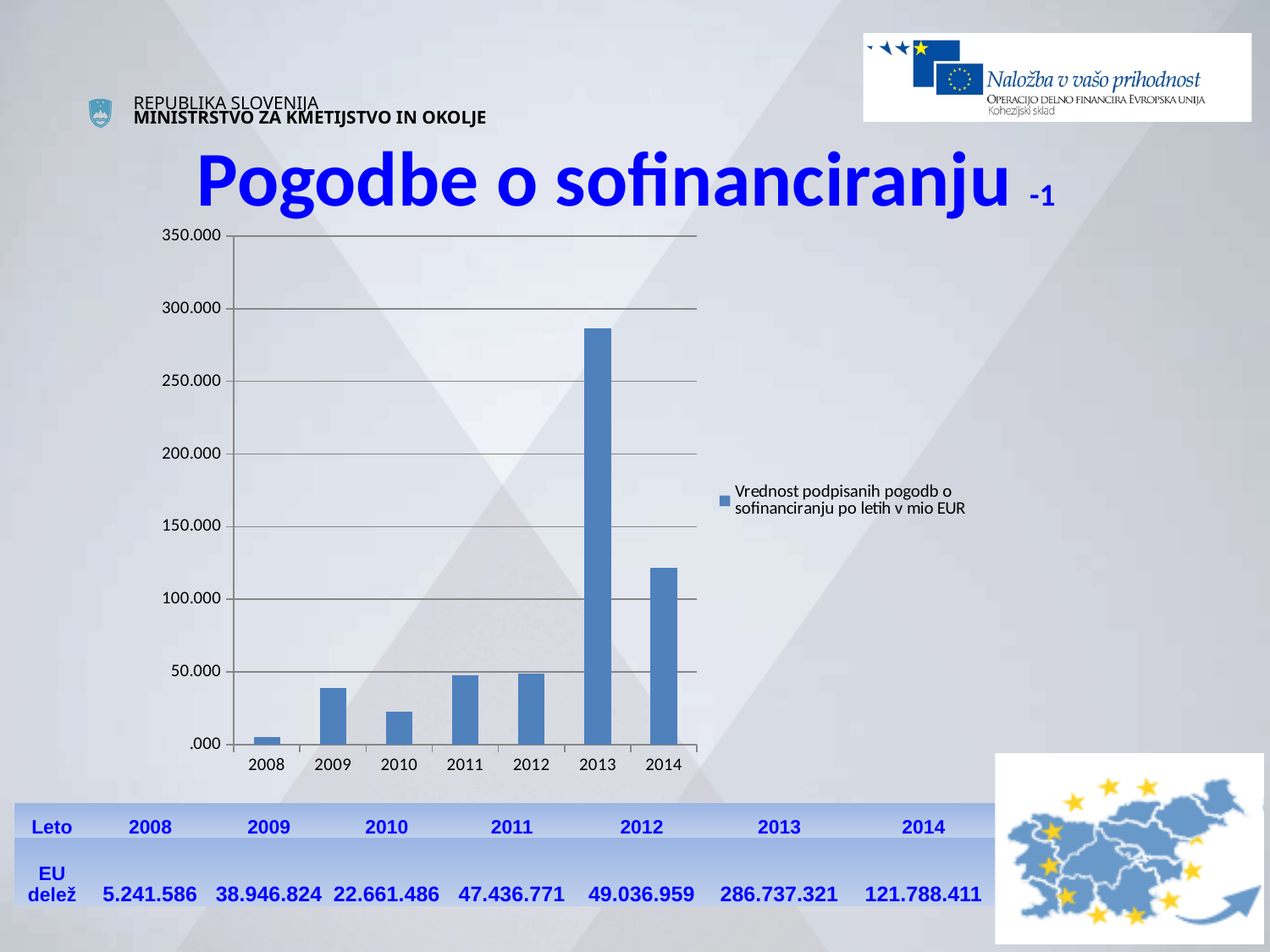
Which year has the larger bar, 2009 or 2010? 2009 Does the value rise or fall from 2013 to 2014? fall According to the table below the chart, what is the EU delež for 2013? 286.737.321 How many years are shown on the x axis of the chart? 7 Is the value for 2010 greater or less than 50.000? less Which year has the lowest bar in the chart? 2008 Is the value for 2014 greater or less than 100.000? greater What kind of chart is shown on the slide? bar chart Which year has the highest bar in the chart? 2013 How many series does the chart legend list? 1 What is the legend entry of the series in the chart? Vrednost podpisanih pogodb o sofinanciranju po letih v mio EUR Is the value for 2013 greater or less than 250.000? greater